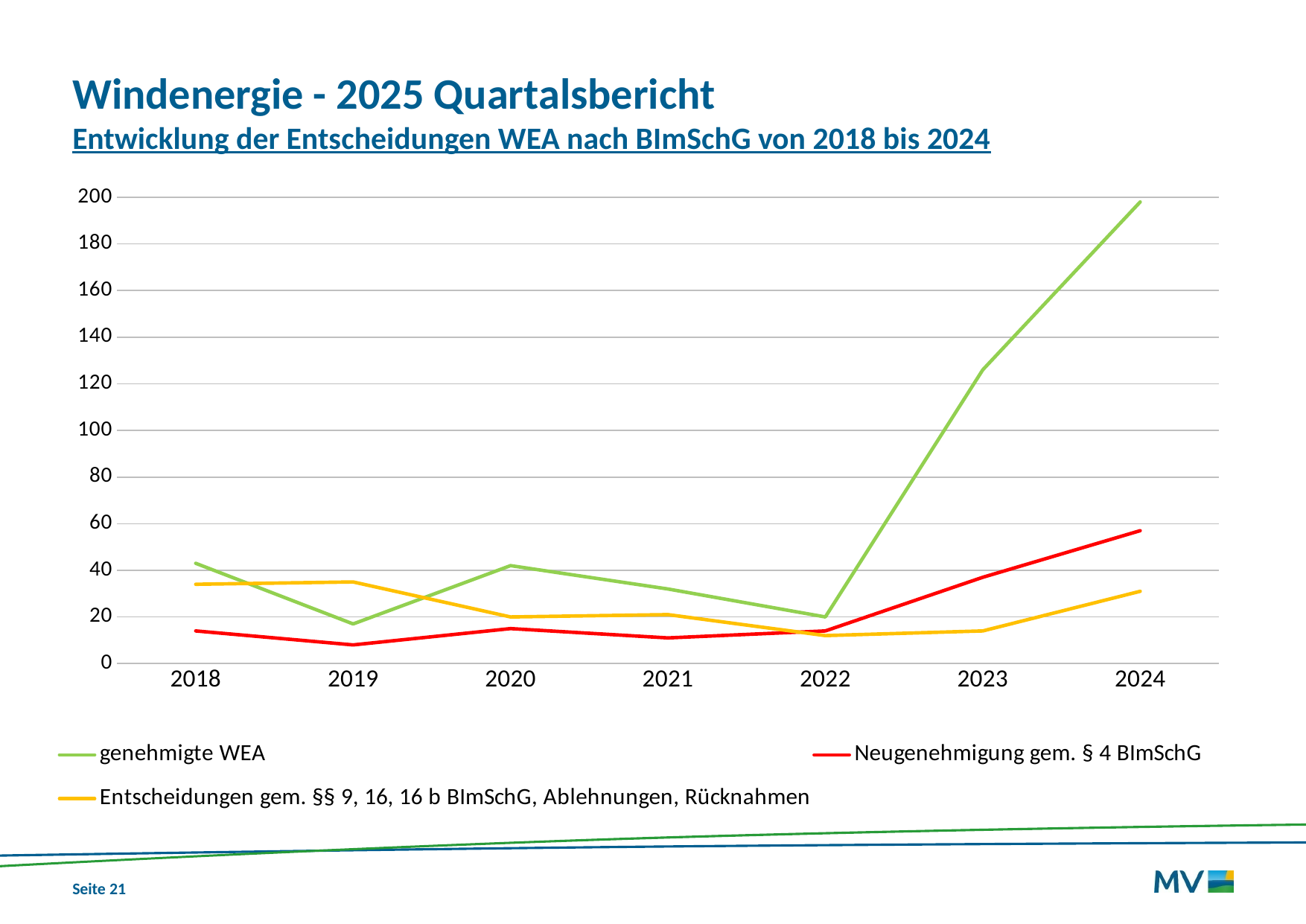
In which year is the value for Neugenehmigung gem. § 4 BImSchG highest? 2024 In 2019, which is larger: genehmigte WEA or Entscheidungen gem. §§ 9, 16, 16 b BImSchG, Ablehnungen, Rücknahmen? Entscheidungen gem. §§ 9, 16, 16 b BImSchG, Ablehnungen, Rücknahmen How many years are shown on the x axis? 7 What kind of chart is shown on the slide? line chart In which year is the value for genehmigte WEA highest? 2024 Is the value for Entscheidungen gem. §§ 9, 16, 16 b BImSchG, Ablehnungen, Rücknahmen in 2018 greater or less than 40? less Is the value for genehmigte WEA in 2023 greater or less than 100? greater In 2024, which is larger: Neugenehmigung gem. § 4 BImSchG or Entscheidungen gem. §§ 9, 16, 16 b BImSchG, Ablehnungen, Rücknahmen? Neugenehmigung gem. § 4 BImSchG Does the value for genehmigte WEA rise or fall from 2022 to 2024? rise How many series does the legend list? 3 What colour is the line for genehmigte WEA? green Is the value for genehmigte WEA in 2024 greater or less than 180? greater